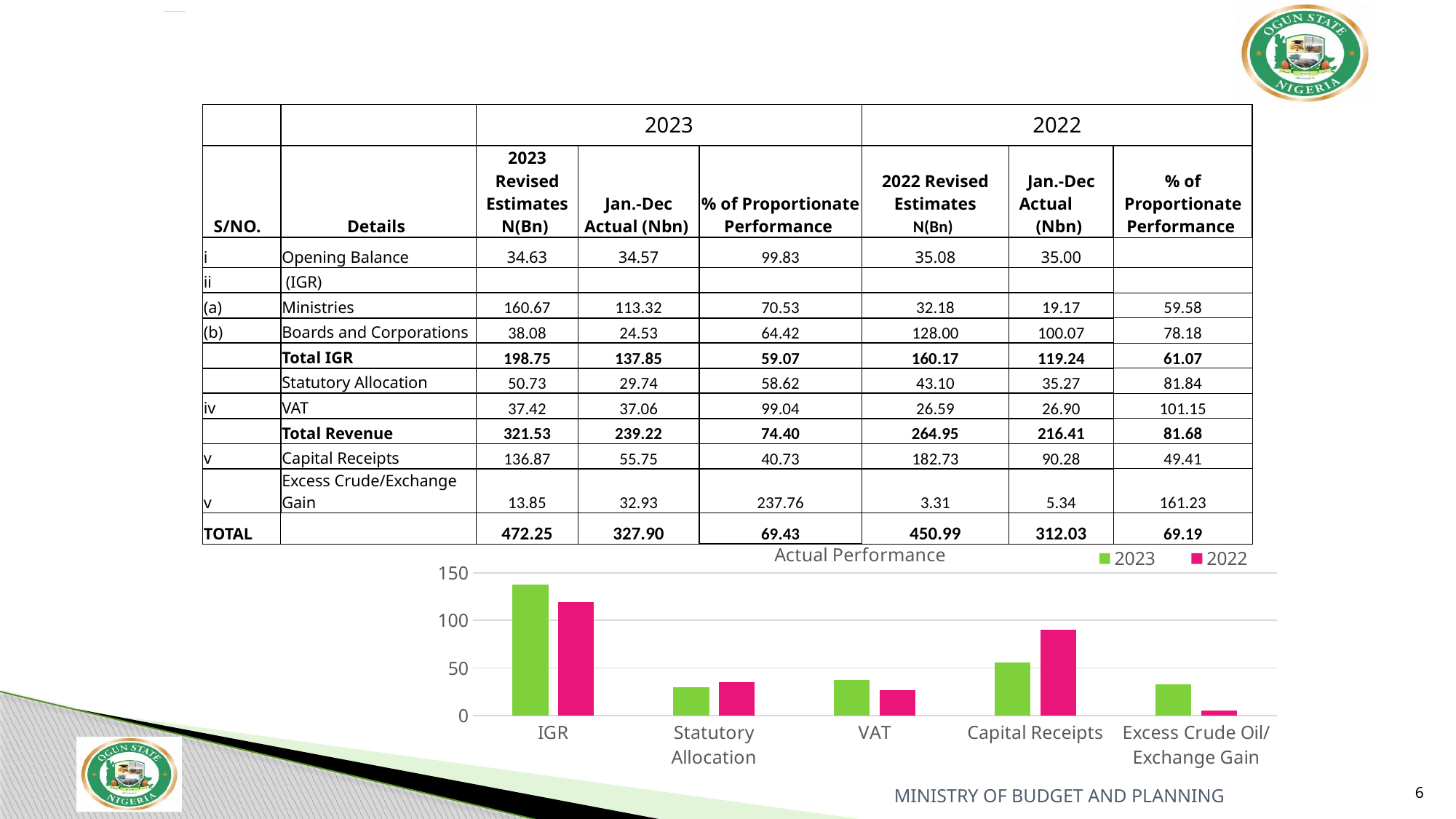
In the chart, is the 2023 value for IGR greater or less than 100? greater In the chart, which is larger for Excess Crude Oil/ Exchange Gain: the 2023 bar or the 2022 bar? 2023 In the chart, is the 2023 value for Statutory Allocation greater or less than 50? less How many series does the chart's legend list? 2 In the chart, which is larger for Capital Receipts: the 2023 bar or the 2022 bar? 2022 What kind of chart is shown below the table on the slide? bar chart Which colour represents the 2022 series in the chart? pink In the chart, is the 2022 value for Capital Receipts greater or less than 100? less What is the title of the chart on the slide? Actual Performance In the chart, which category has the lowest 2022 bar? Excess Crude Oil/ Exchange Gain In the chart, which category has the highest 2023 bar? IGR How many categories are shown along the x axis of the chart? 5